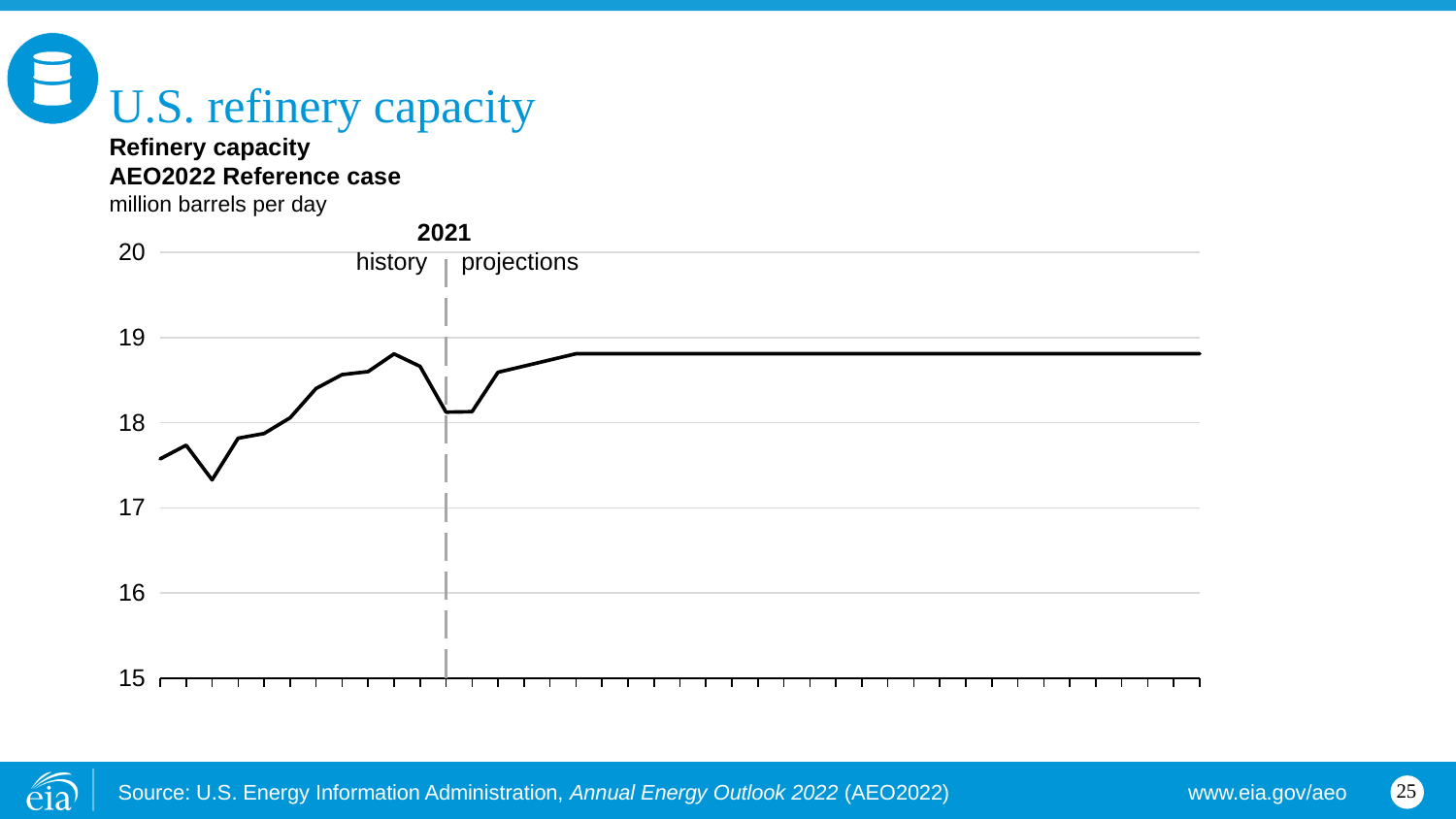
Is the lowest value on the line greater or less than 18 million barrels per day? less What are the lowest and highest values shown on the vertical axis? 15 and 20 After the initial rise following 2021, does the projected line rise, fall, or stay flat? stay flat Is the lowest point of the line in the history period or the projection period? history Which year marks the boundary between history and projections on the chart? 2021 How many data series are plotted on the chart? 1 What kind of chart is shown on the slide? line chart Is the projected refinery capacity at the end of the projection period greater or less than 19 million barrels per day? less Is the projected refinery capacity at the end of the projection period greater or less than 18 million barrels per day? greater What unit is the chart's vertical axis measured in? million barrels per day What is the title of the chart? Refinery capacity, AEO2022 Reference case